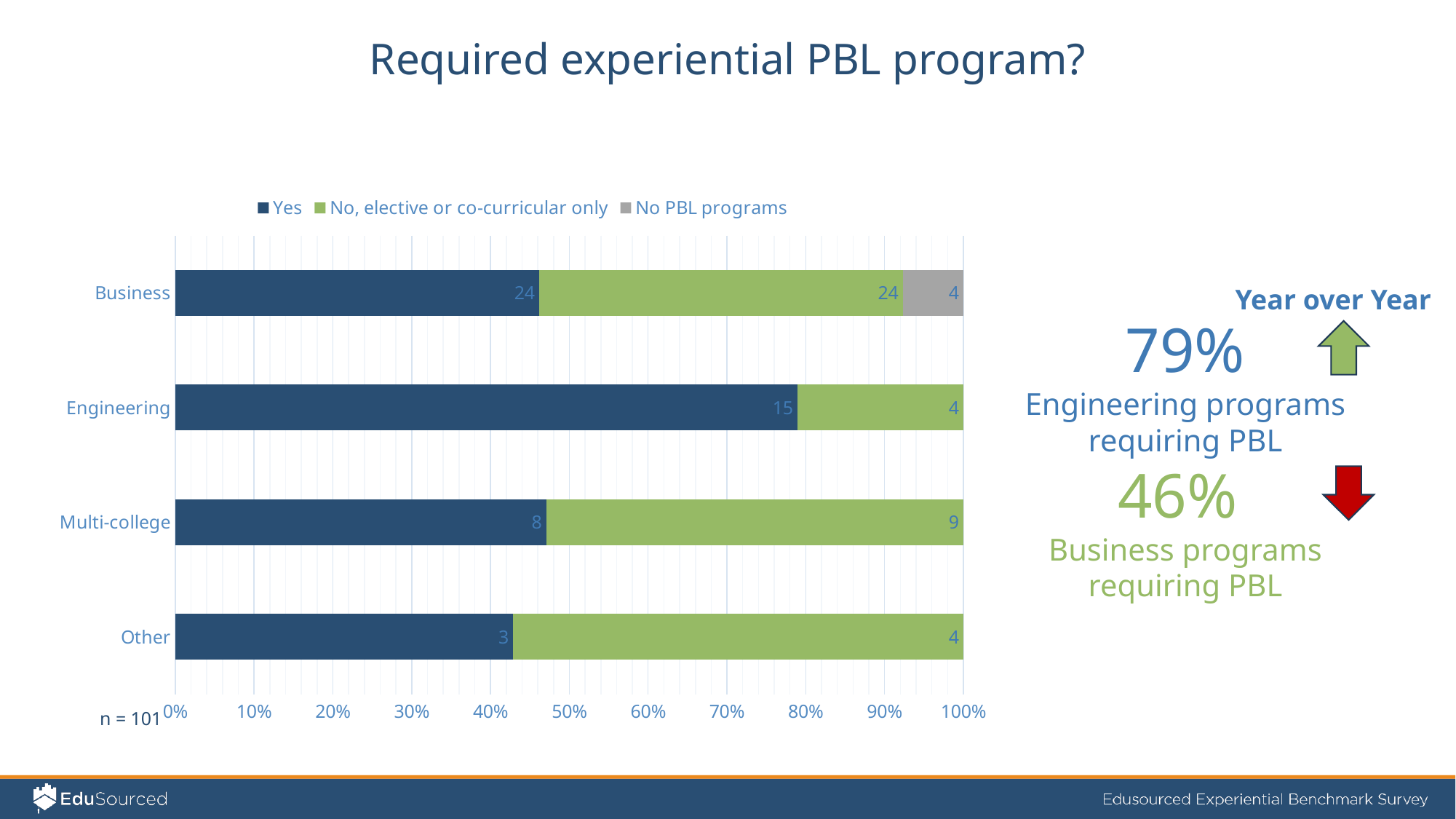
What is the 'No PBL programs' value for Business? 4 Which category has the highest 'Yes' value? Business Is the 'Yes' segment for Engineering greater or less than 70% of the bar? greater What is the 'No, elective or co-curricular only' value for Multi-college? 9 What is the 'Yes' value for Business? 24 How many categories are shown on the chart? 4 Which category has the lowest 'Yes' value? Other What is the total of the Business bar? 52 How many series does the legend list? 3 What kind of chart is shown? Stacked bar chart Which is larger for Multi-college: the 'Yes' value or the 'No, elective or co-curricular only' value? No, elective or co-curricular only What is the difference between the 'Yes' values for Engineering and Multi-college? 7